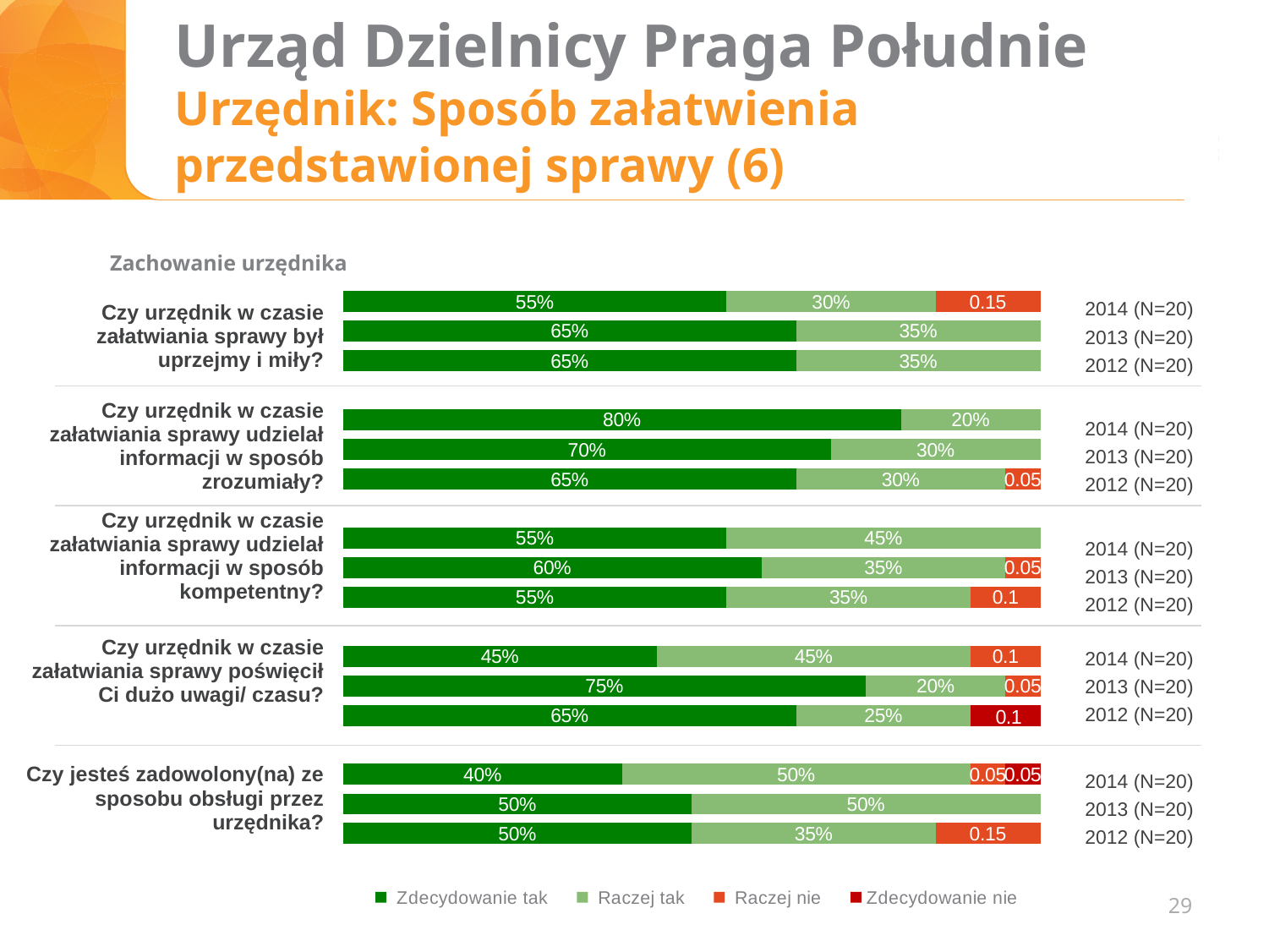
In the chart 'Czy urzędnik w czasie załatwiania sprawy udzielał informacji w sposób zrozumiały?', which year has the highest 'Zdecydowanie tak' value? 2014 (N=20) In the chart 'Czy urzędnik w czasie załatwiania sprawy poświęcił Ci dużo uwagi/ czasu?', which year has the lowest 'Zdecydowanie tak' value? 2014 (N=20) In the chart 'Czy urzędnik w czasie załatwiania sprawy udzielał informacji w sposób zrozumiały?', what is the 'Raczej tak' value for 2013 (N=20)? 30% In the chart 'Czy urzędnik w czasie załatwiania sprawy poświęcił Ci dużo uwagi/ czasu?', is the 'Zdecydowanie tak' value larger for 2013 (N=20) or 2012 (N=20)? 2013 (N=20) In the chart 'Czy urzędnik w czasie załatwiania sprawy był uprzejmy i miły?', what is the 'Zdecydowanie tak' value for 2014 (N=20)? 55% In the chart 'Czy jesteś zadowolony(na) ze sposobu obsługi przez urzędnika?', what is the 'Raczej nie' value for 2012 (N=20)? 0.15 In the chart 'Czy urzędnik w czasie załatwiania sprawy udzielał informacji w sposób kompetentny?', what is the difference between the 'Zdecydowanie tak' values for 2013 (N=20) and 2012 (N=20)? 5% In the chart 'Czy urzędnik w czasie załatwiania sprawy był uprzejmy i miły?', what is the 'Raczej nie' value for 2014 (N=20)? 0.15 In the chart 'Czy urzędnik w czasie załatwiania sprawy udzielał informacji w sposób kompetentny?', what is the 'Raczej nie' value for 2012 (N=20)? 0.1 In the chart 'Czy jesteś zadowolony(na) ze sposobu obsługi przez urzędnika?', what is the 'Raczej tak' value for 2014 (N=20)? 50% What kind of chart is used on this slide? Stacked bar chart How many series does the legend list? 4